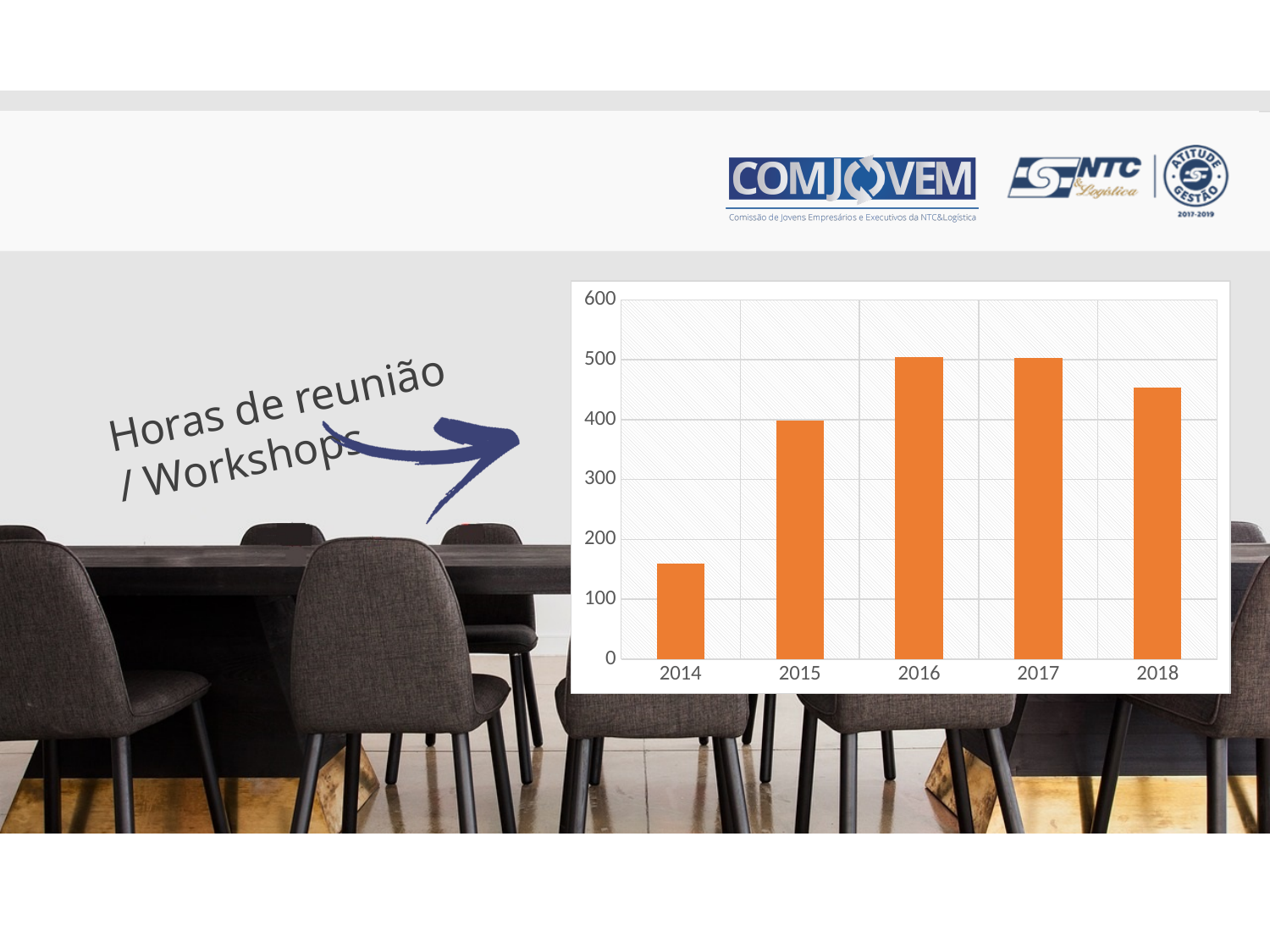
Is the value for 2018 greater or less than 500? less What label accompanies the chart on the left side of the slide? Horas de reunião / Workshops Is the value for 2014 greater or less than 100? greater Do the values rise or fall from 2014 to 2016? rise Which year has the lowest bar in the chart? 2014 How many years are shown on the x axis of the chart? 5 Which is larger, the value for 2017 or the value for 2018? 2017 What kind of chart is shown on the slide? bar chart Is the value for 2014 greater or less than 200? less Which is larger, the value for 2015 or the value for 2016? 2016